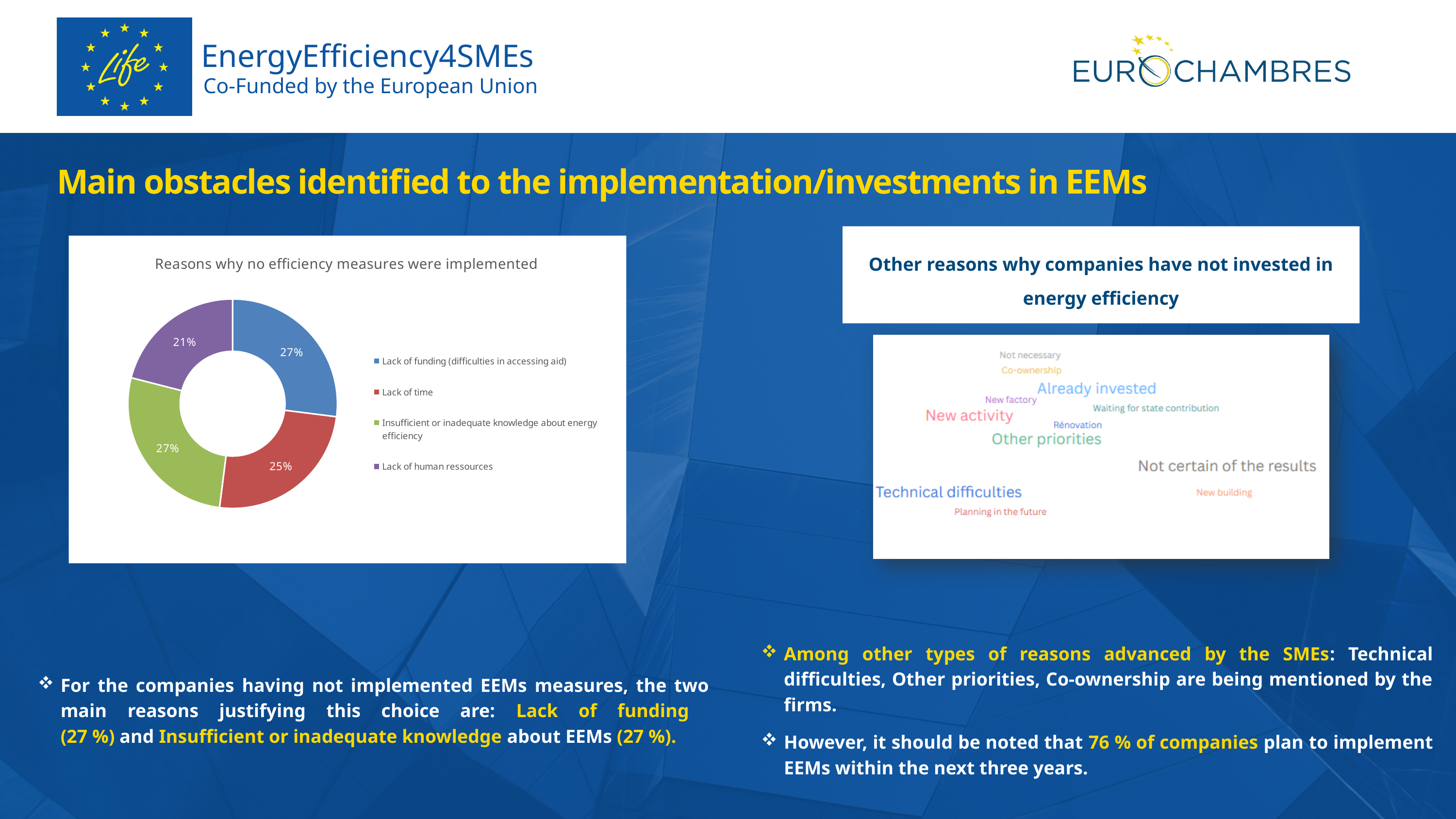
What kind of chart is shown under the title "Reasons why no efficiency measures were implemented"? Doughnut chart What is the combined share of "Lack of funding (difficulties in accessing aid)" and "Insufficient or inadequate knowledge about energy efficiency" in the doughnut chart? 54% What percentage of the doughnut chart is "Lack of time"? 25% What is the title of the chart on the left of the slide? Reasons why no efficiency measures were implemented What percentage of the doughnut chart is "Insufficient or inadequate knowledge about energy efficiency"? 27% What is the difference in percentage points between "Lack of funding (difficulties in accessing aid)" and "Lack of human ressources" in the doughnut chart? 6 percentage points Which colour represents "Lack of time" in the doughnut chart? Red Which reason has the smallest share in the doughnut chart? Lack of human ressources Which is larger in the doughnut chart: "Lack of time" or "Lack of human ressources"? Lack of time How many categories does the doughnut chart show? 4 What percentage of the doughnut chart is "Lack of human ressources"? 21% What percentage of the doughnut chart is "Lack of funding (difficulties in accessing aid)"? 27%